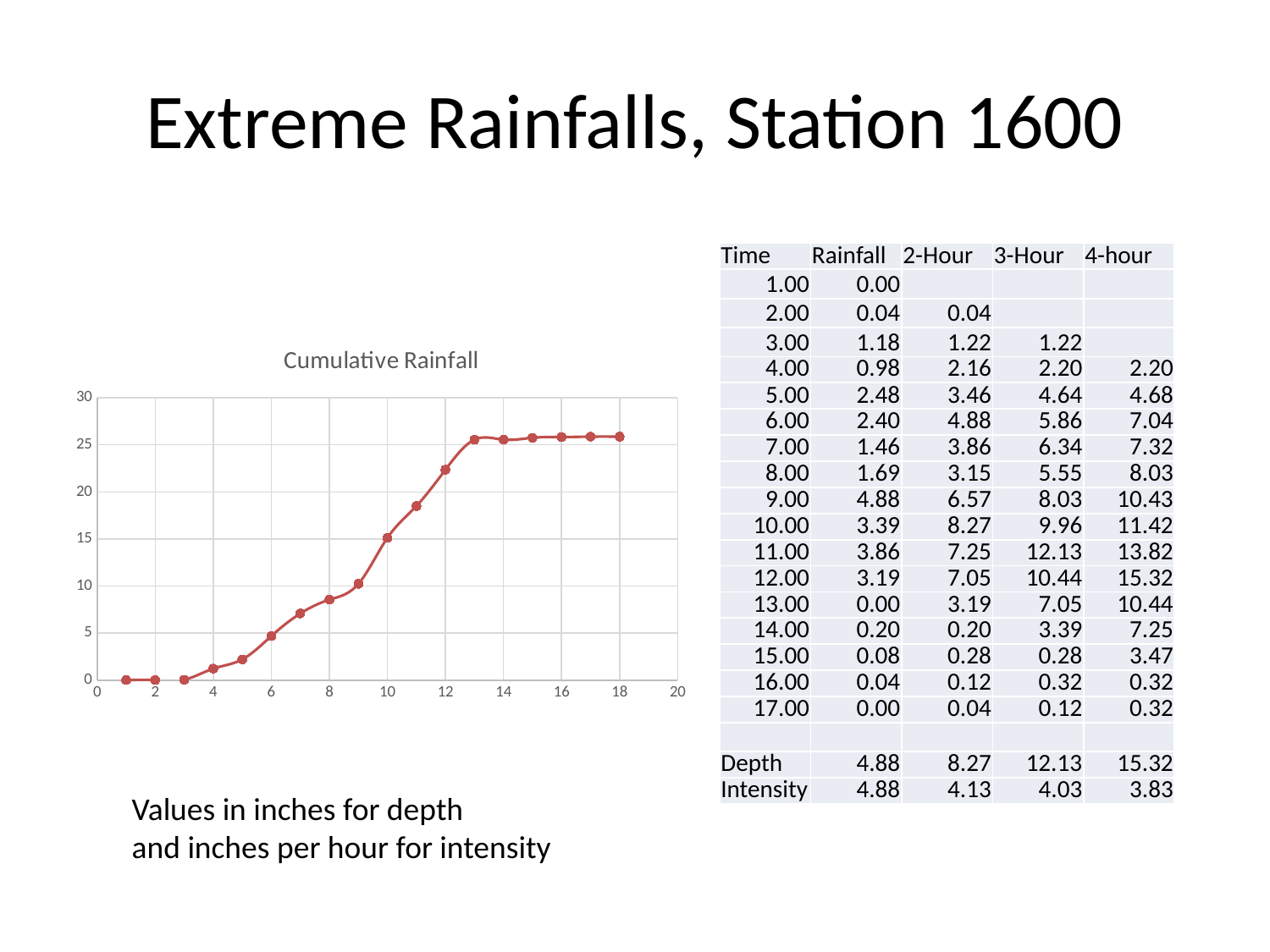
On the Cumulative Rainfall chart, which has the larger value: x = 10 or x = 6? x = 10 Is the value at x = 4 on the Cumulative Rainfall chart greater or less than 5? less What is the highest value shown on the y axis of the Cumulative Rainfall chart? 30 Is the value at x = 12 on the Cumulative Rainfall chart greater or less than 20? greater What kind of chart is shown on the slide? line chart Is the value at x = 10 on the Cumulative Rainfall chart greater or less than 10? greater What is the title of the chart? Cumulative Rainfall Do the values on the Cumulative Rainfall chart generally rise or fall as the x axis increases? rise How many data points are plotted on the Cumulative Rainfall line? 18